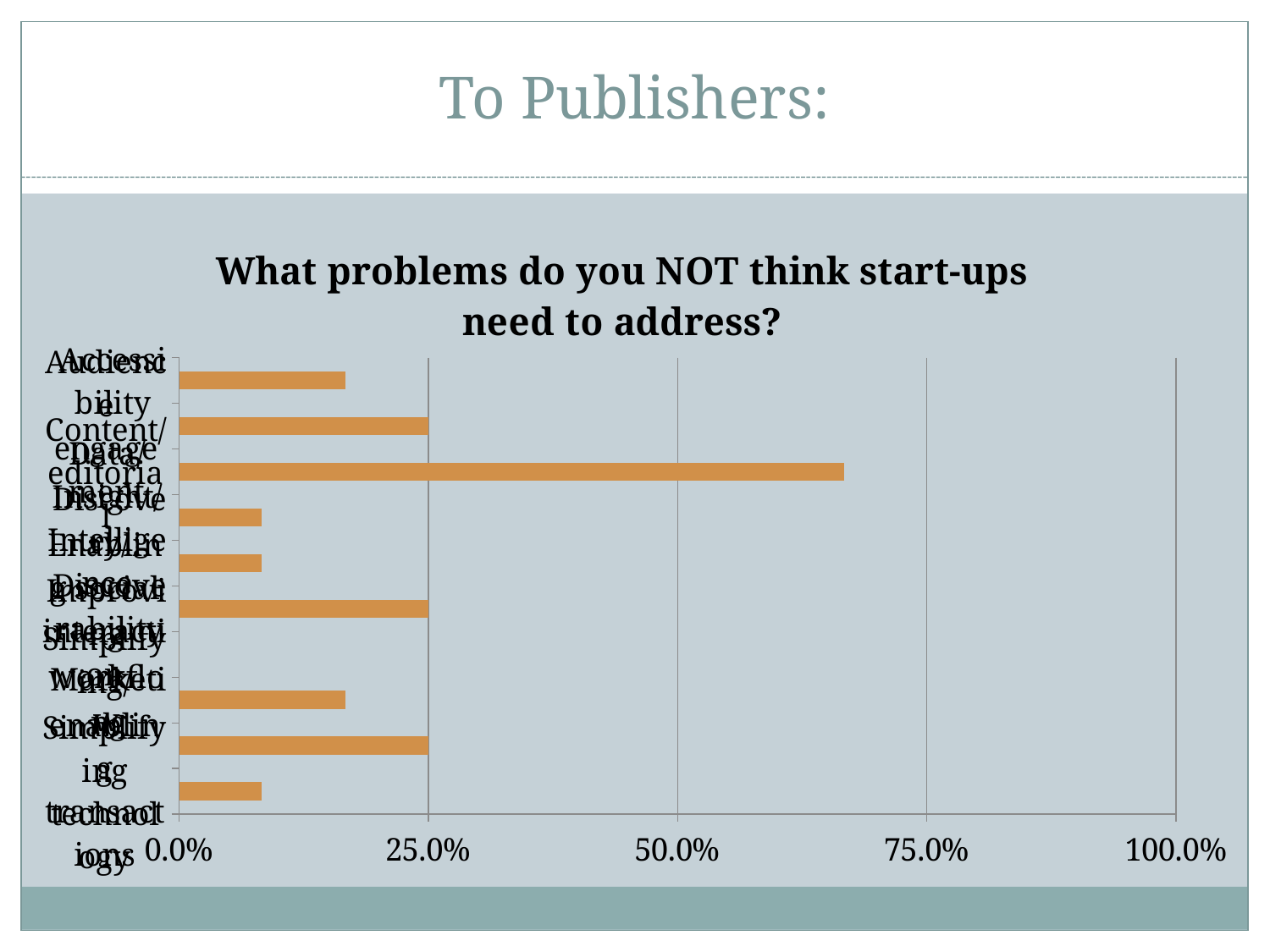
Is the value of the bottom bar greater or less than 25.0%? less What kind of chart is shown on the slide? bar chart Which is larger, the top bar or the second bar from the top? the second bar from the top What is the title of the chart? What problems do you NOT think start-ups need to address? Is the value of the longest bar greater or less than 50.0%? greater What is the highest value shown on the x axis? 100.0% What value does the second bar from the top reach on the x axis? 25.0% Is the value of the longest bar greater or less than 75.0%? less Which bar is the longest, counting from the top? the third bar How many bars are drawn on the chart? 9